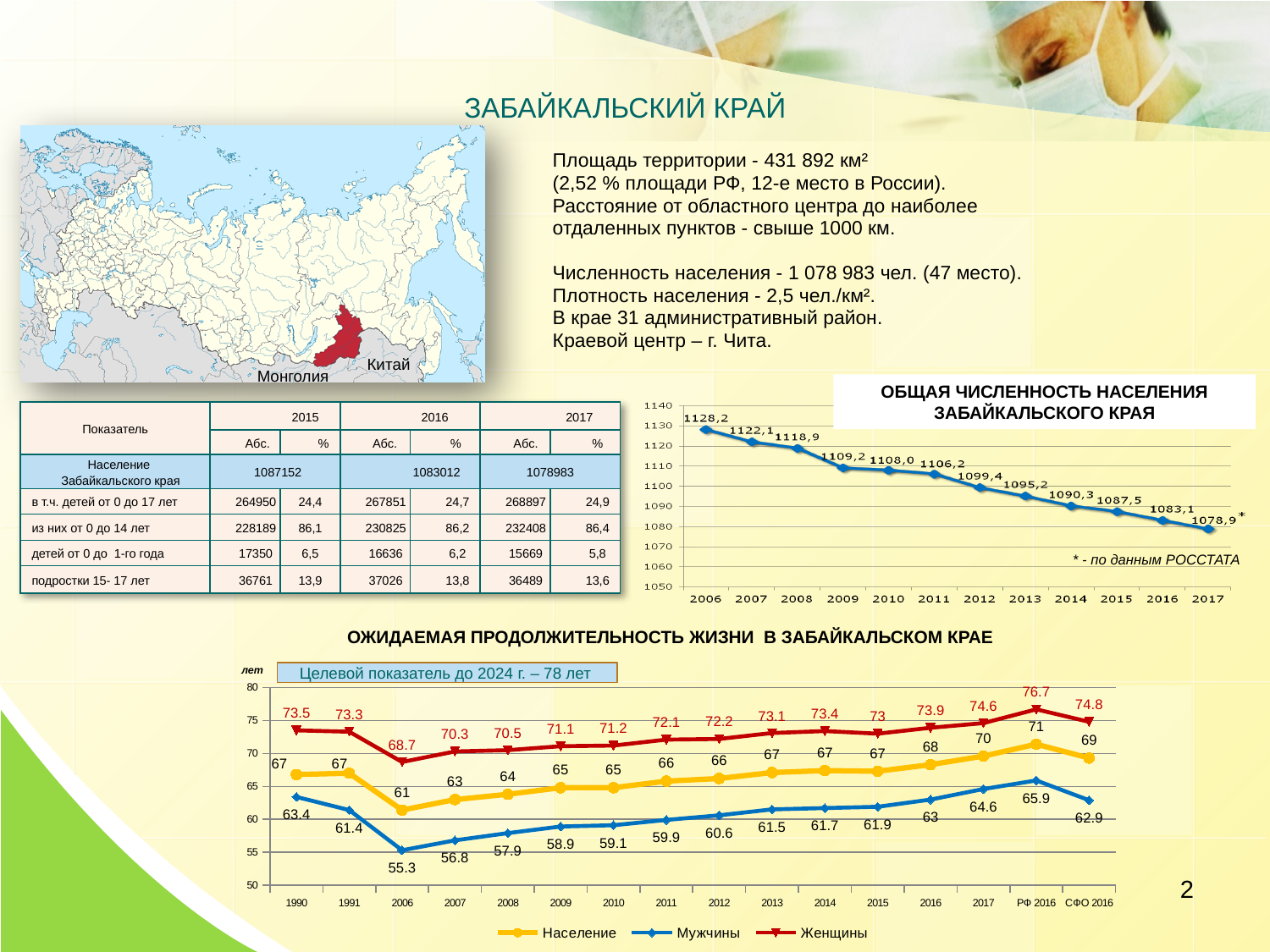
In the chart 'ОЖИДАЕМАЯ ПРОДОЛЖИТЕЛЬНОСТЬ ЖИЗНИ В ЗАБАЙКАЛЬСКОМ КРАЕ', how many series does the legend list? 3 In the chart 'ОЖИДАЕМАЯ ПРОДОЛЖИТЕЛЬНОСТЬ ЖИЗНИ В ЗАБАЙКАЛЬСКОМ КРАЕ', what is the value for Мужчины in 2006? 55.3 In the chart 'ОЖИДАЕМАЯ ПРОДОЛЖИТЕЛЬНОСТЬ ЖИЗНИ В ЗАБАЙКАЛЬСКОМ КРАЕ', what is the value for Женщины in 2017? 74.6 What type of chart is 'ОЖИДАЕМАЯ ПРОДОЛЖИТЕЛЬНОСТЬ ЖИЗНИ В ЗАБАЙКАЛЬСКОМ КРАЕ'? line chart In the chart 'ОБЩАЯ ЧИСЛЕННОСТЬ НАСЕЛЕНИЯ ЗАБАЙКАЛЬСКОГО КРАЯ', what is the value for 2017? 1078,9 In the chart 'ОБЩАЯ ЧИСЛЕННОСТЬ НАСЕЛЕНИЯ ЗАБАЙКАЛЬСКОГО КРАЯ', how many years are plotted? 12 In the chart 'ОЖИДАЕМАЯ ПРОДОЛЖИТЕЛЬНОСТЬ ЖИЗНИ В ЗАБАЙКАЛЬСКОМ КРАЕ', what is the difference between Женщины and Мужчины in 2016? 10.9 In the chart 'ОБЩАЯ ЧИСЛЕННОСТЬ НАСЕЛЕНИЯ ЗАБАЙКАЛЬСКОГО КРАЯ', which year has the lowest value? 2017 In the chart 'ОЖИДАЕМАЯ ПРОДОЛЖИТЕЛЬНОСТЬ ЖИЗНИ В ЗАБАЙКАЛЬСКОМ КРАЕ', which category has the highest value for Женщины? РФ 2016 In the chart 'ОБЩАЯ ЧИСЛЕННОСТЬ НАСЕЛЕНИЯ ЗАБАЙКАЛЬСКОГО КРАЯ', do the values rise or fall from 2006 to 2017? fall In the chart 'ОБЩАЯ ЧИСЛЕННОСТЬ НАСЕЛЕНИЯ ЗАБАЙКАЛЬСКОГО КРАЯ', what is the value for 2006? 1128,2 In the chart 'ОБЩАЯ ЧИСЛЕННОСТЬ НАСЕЛЕНИЯ ЗАБАЙКАЛЬСКОГО КРАЯ', what is the difference between the 2012 and 2013 values? 4,2